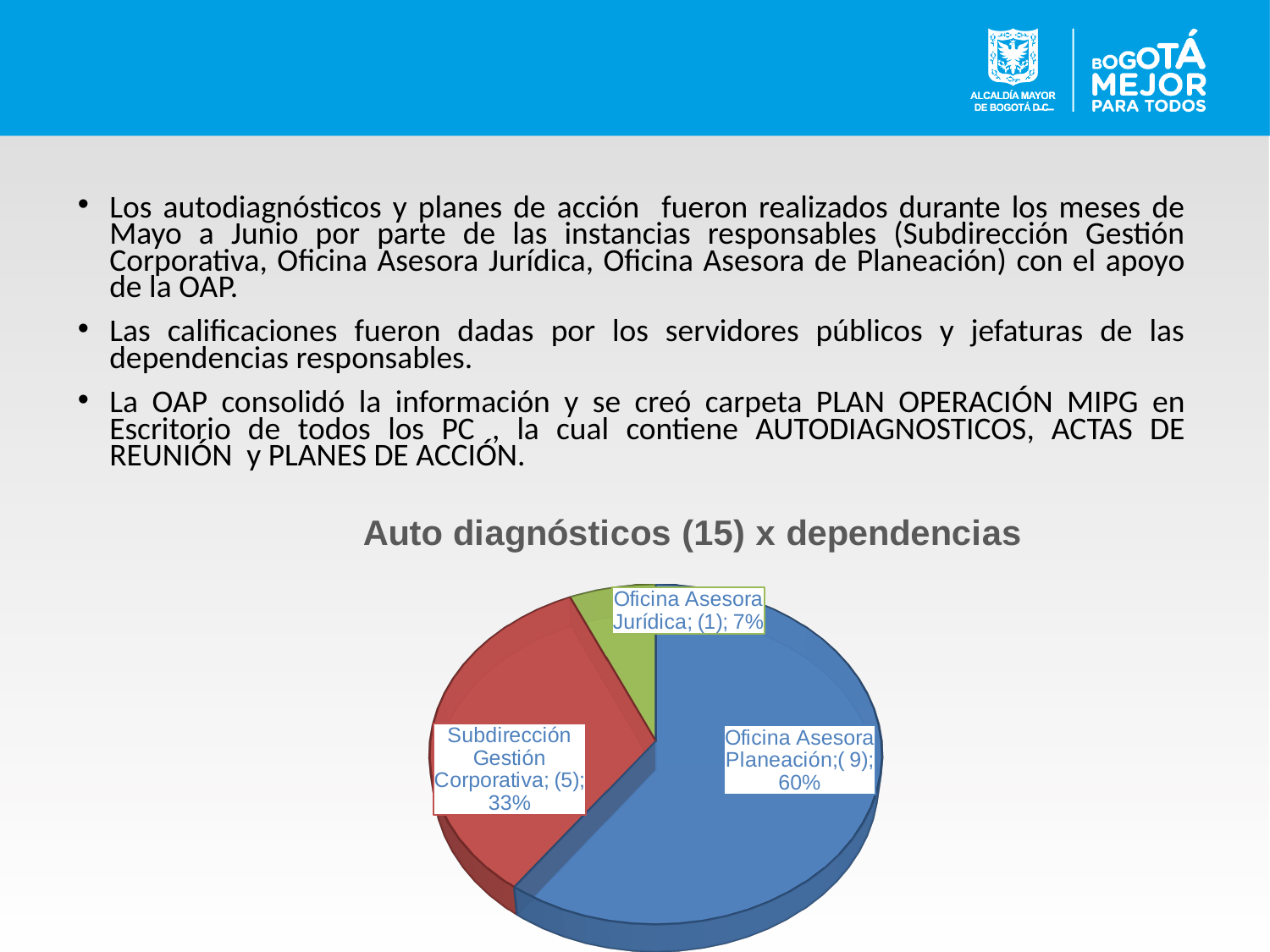
What is the title of the chart? Auto diagnósticos (15) x dependencias Which dependencia has the largest slice? Oficina Asesora Planeación What share of the pie does Oficina Asesora Planeación represent? 60% What share of the pie does Oficina Asesora Jurídica represent? 7% Which dependencia has the smallest slice? Oficina Asesora Jurídica How many auto diagnósticos does Subdirección Gestión Corporativa have? 5 How many auto diagnósticos does Oficina Asesora Planeación have? 9 What share of the pie does Subdirección Gestión Corporativa represent? 33% How many auto diagnósticos does Oficina Asesora Jurídica have? 1 What kind of chart is shown on the slide? Pie chart What is the difference in auto diagnósticos between Oficina Asesora Planeación and Subdirección Gestión Corporativa? 4 How many slices does the pie chart have? 3